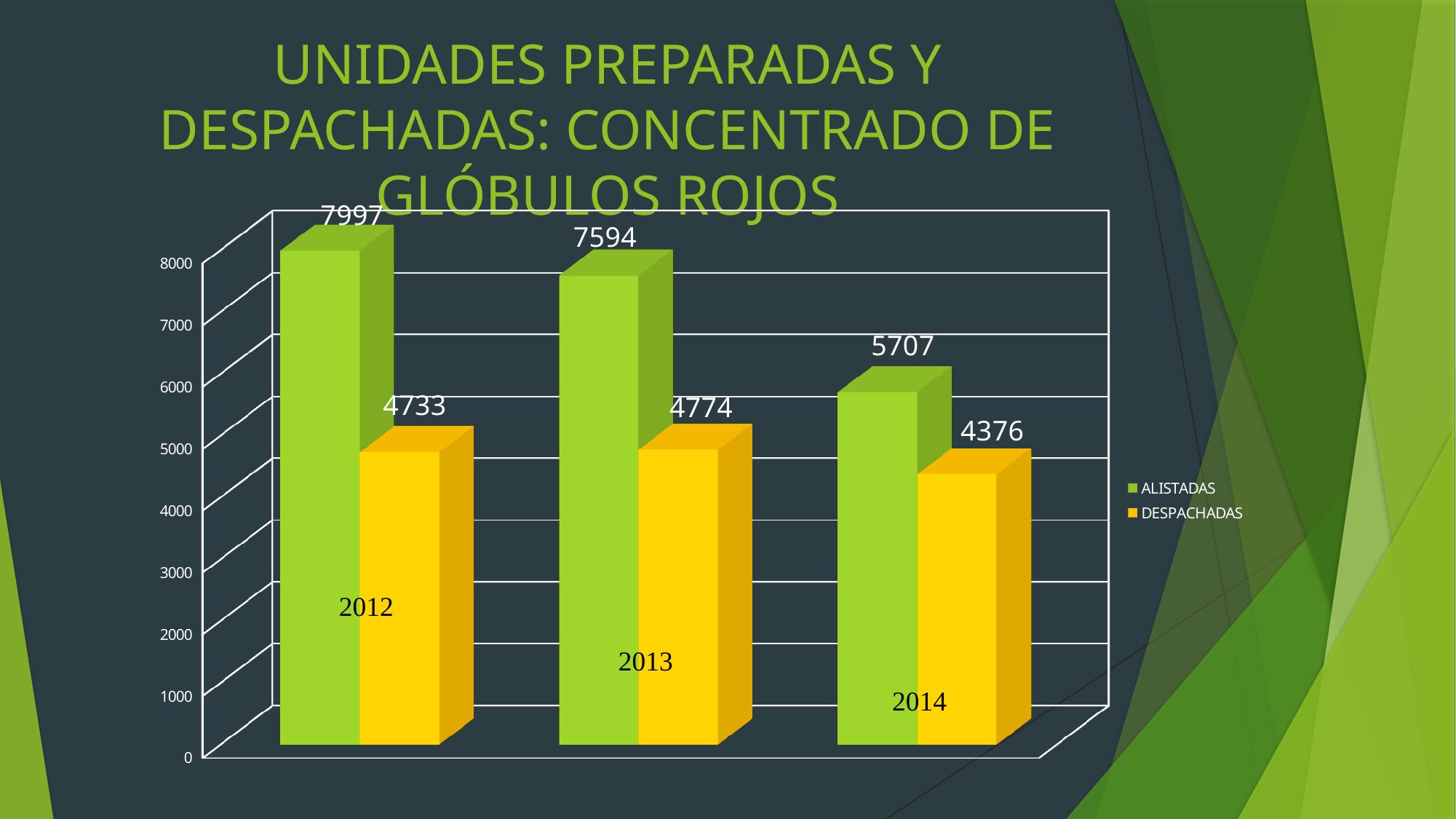
What is the DESPACHADAS value for 2013? 4774 Which year has the highest ALISTADAS value? 2012 What is the difference between ALISTADAS and DESPACHADAS in 2012? 3264 Which year has the lowest DESPACHADAS value? 2014 How many series does the legend list? 2 What is the ALISTADAS value for 2012? 7997 What is the DESPACHADAS value for 2014? 4376 What is the difference between the ALISTADAS values for 2013 and 2014? 1887 What kind of chart is shown on the slide? Bar chart Do the ALISTADAS values rise or fall from 2012 to 2014? Fall Which is larger, ALISTADAS in 2013 or ALISTADAS in 2014? ALISTADAS in 2013 How many years are shown on the x axis? 3